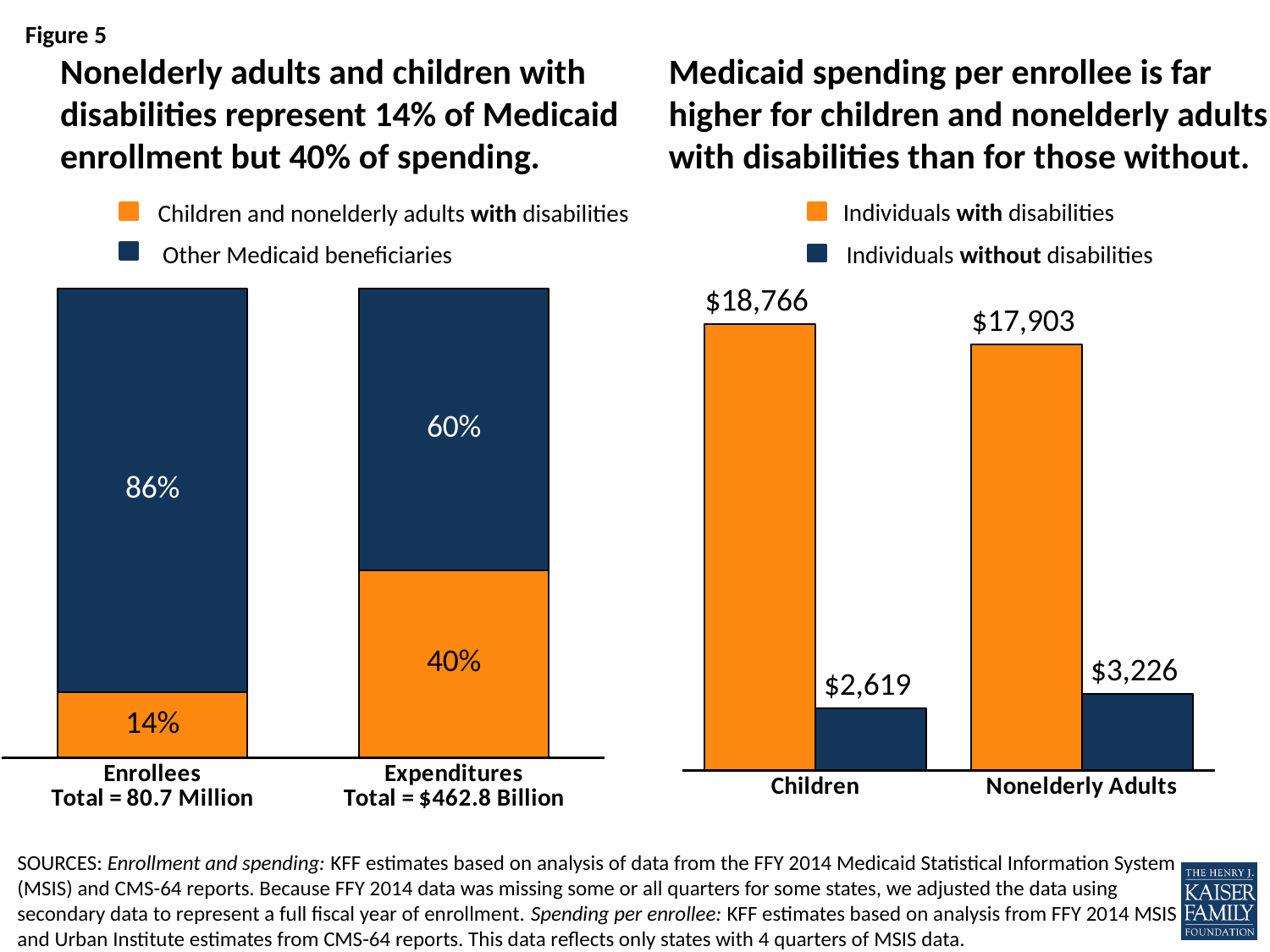
In the left chart, what kind of chart is shown? Stacked bar chart In the left chart, what share of expenditures goes to other Medicaid beneficiaries? 60% In the left chart, what is the total shown for Expenditures? $462.8 Billion In the left chart, how many percentage points higher is the share of other Medicaid beneficiaries for Enrollees than for Expenditures? 26 In the left chart, how many series does the legend list? 2 In the right chart, what is Medicaid spending per enrollee for nonelderly adults without disabilities? $3,226 In the right chart, which category has the highest spending per enrollee? Children with disabilities In the right chart, what is Medicaid spending per enrollee for children with disabilities? $18,766 In the right chart, what is the difference in spending per enrollee between nonelderly adults with disabilities and nonelderly adults without disabilities? $14,677 In the left chart, what share of enrollees are children and nonelderly adults with disabilities? 14% In the right chart, which category has the lowest spending per enrollee? Children without disabilities In the right chart, how many categories are shown on the x axis? 2